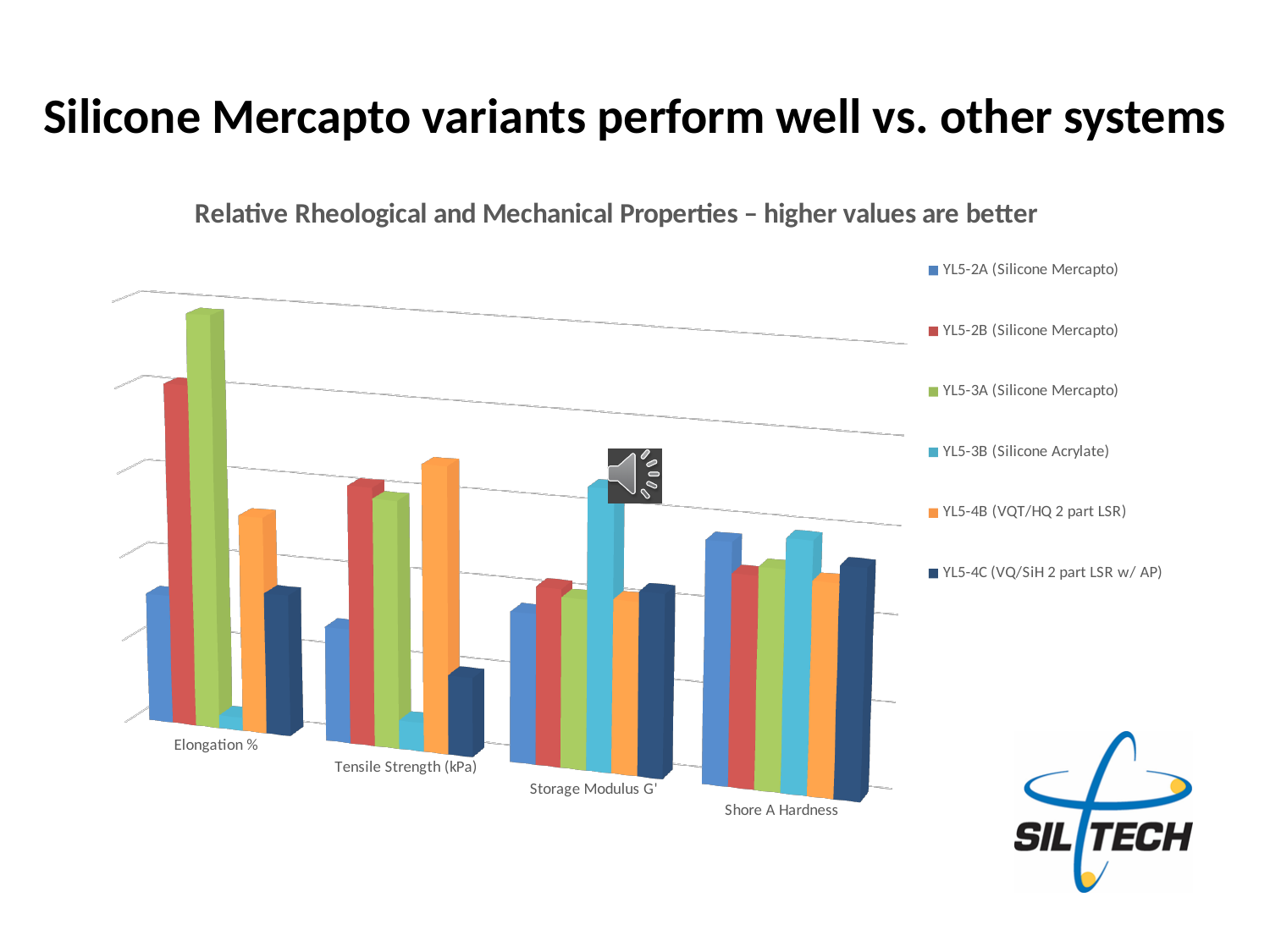
How many series does the chart's legend list? 6 What is the title of the chart? Relative Rheological and Mechanical Properties – higher values are better Which series has the lowest value for Tensile Strength (kPa)? YL5-3B (Silicone Acrylate) For Tensile Strength (kPa), which is larger: YL5-2A (Silicone Mercapto) or YL5-4C (VQ/SiH 2 part LSR w/ AP)? YL5-2A (Silicone Mercapto) Which series has the highest value for Tensile Strength (kPa)? YL5-4B (VQT/HQ 2 part LSR) Which series has the highest value for Storage Modulus G'? YL5-3B (Silicone Acrylate) Which material system does the legend give for the series YL5-4B? VQT/HQ 2 part LSR What kind of chart is shown on the slide? Bar chart How many categories are shown on the x axis of the chart? 4 For Elongation %, which is larger: YL5-2B (Silicone Mercapto) or YL5-4B (VQT/HQ 2 part LSR)? YL5-2B (Silicone Mercapto) Which series has the highest value for Elongation %? YL5-3A (Silicone Mercapto) Which series has the lowest value for Elongation %? YL5-3B (Silicone Acrylate)